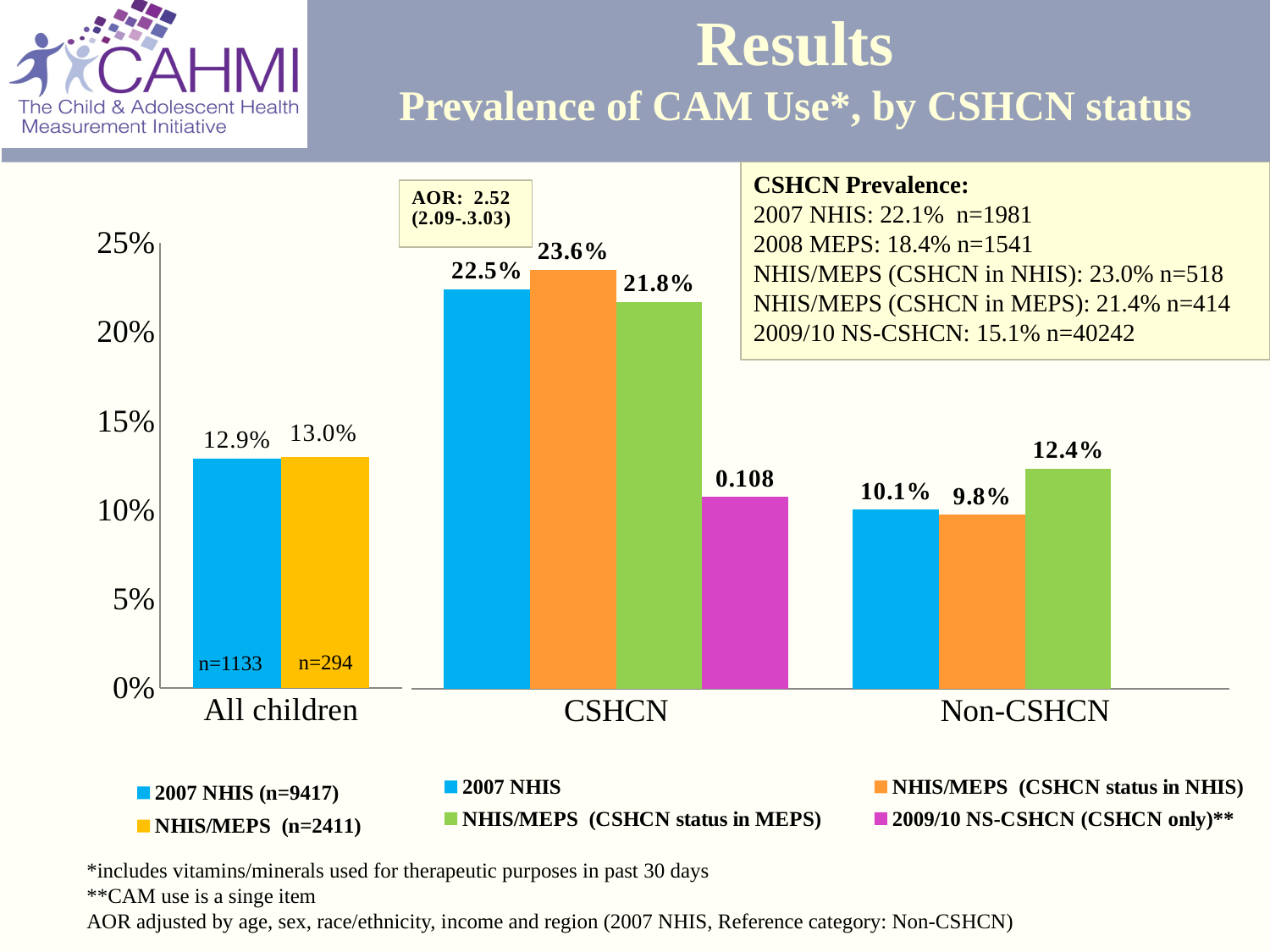
Which bar in the CSHCN group has the highest labelled percentage? NHIS/MEPS (CSHCN status in NHIS), 23.6% What is the CAM use prevalence for 2007 NHIS among CSHCN? 22.5% What type of chart is shown on the slide? Bar chart What is the value labelled on the 2009/10 NS-CSHCN (CSHCN only) bar? 0.108 What is the difference between the 2007 NHIS values for CSHCN and Non-CSHCN? 12.4 percentage points How many category groups are shown on the x axis? 3 What is the value for NHIS/MEPS (CSHCN status in MEPS) in the Non-CSHCN group? 12.4% Which bar in the Non-CSHCN group is the lowest? NHIS/MEPS (CSHCN status in NHIS), 9.8% What is the value for NHIS/MEPS (CSHCN status in NHIS) in the CSHCN group? 23.6% What is the value for 2007 NHIS (n=9417) for All children? 12.9% Is the 2007 NHIS value for CSHCN greater or less than 20%? greater What AOR value is shown in the box above the CSHCN bars? 2.52 (2.09-3.03)